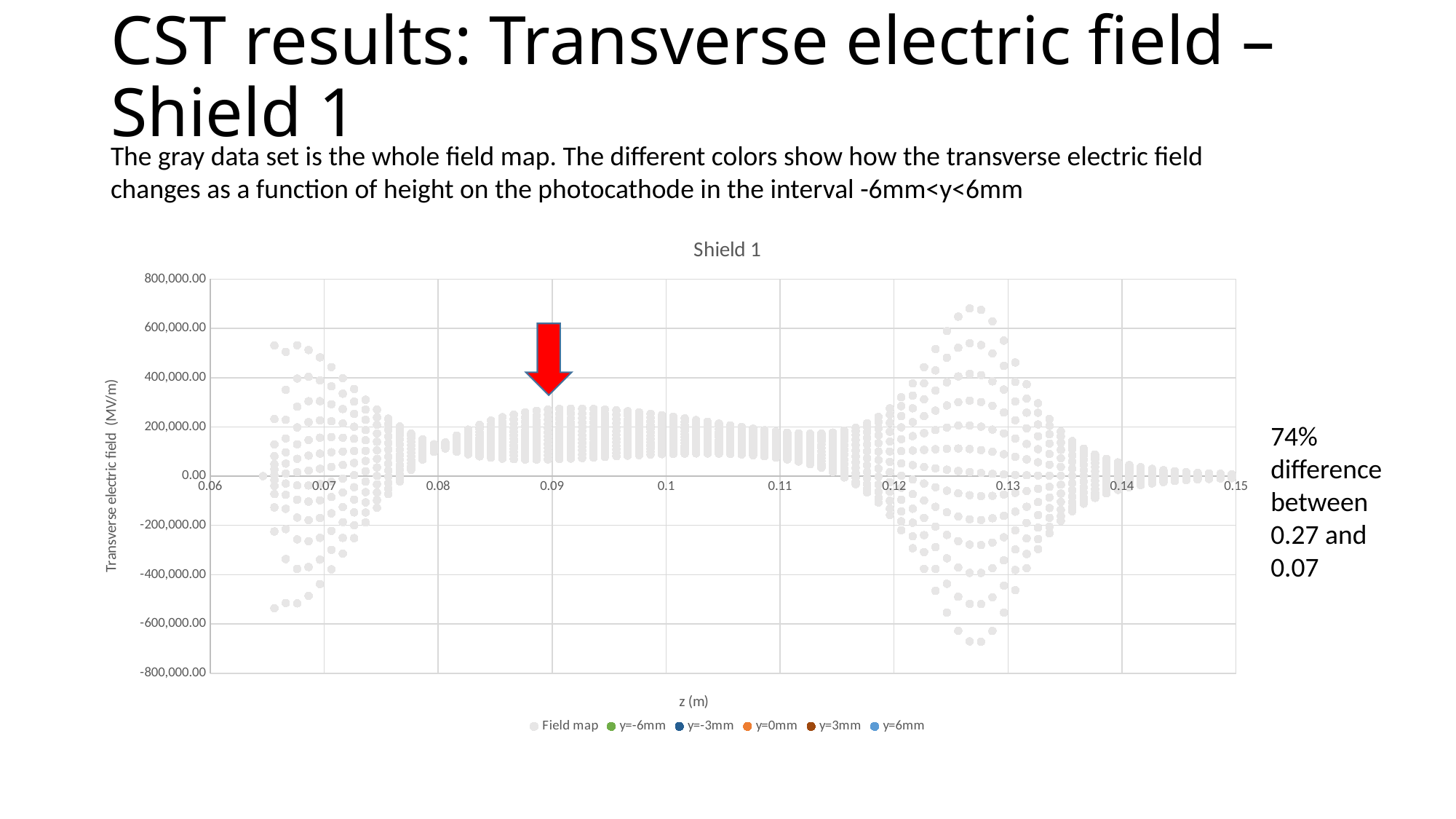
How many series does the chart legend list? 6 Is the lowest Field map value near z = 0.13 greater or less than -600,000.00? less What kind of chart is shown on the slide? scatter chart Is the highest Field map value near z = 0.13 greater or less than 600,000.00? greater What is the label of the x axis of the chart? z (m) Are the Field map values at z = 0.09 greater or less than 400,000.00? less What is the title of the chart? Shield 1 Which series in the legend is plotted in gray? Field map